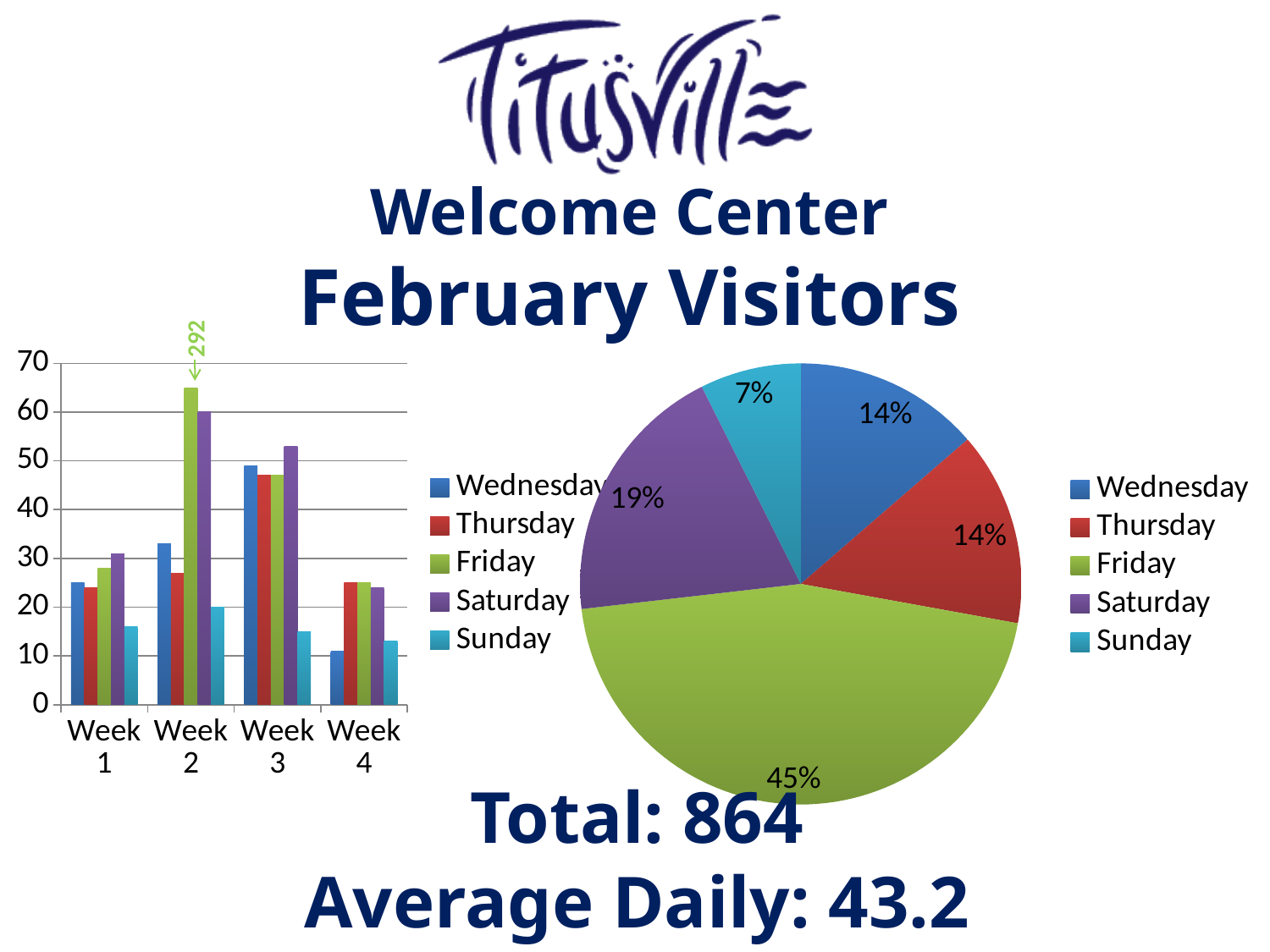
In the pie chart, what share of February visitors came on Saturday? 19% In the pie chart, which day has the smallest slice? Sunday How many days does the legend of the pie chart list? 5 In the bar chart on the left, is the value for Friday in Week 2 greater or less than 60? greater In the bar chart on the left, which is larger: the Friday bar in Week 2 or the Friday bar in Week 1? Week 2 In the pie chart, what share of February visitors came on Sunday? 7% In the pie chart, how many percentage points larger is Friday's share than Saturday's share? 26% In the bar chart on the left, how many weeks are shown on the x axis? 4 In the bar chart on the left, is the value for Wednesday in Week 4 greater or less than 20? less What kind of chart is the chart on the left of the slide? bar chart In the pie chart, what share of February visitors came on Friday? 45% In the pie chart, which day has the largest slice? Friday